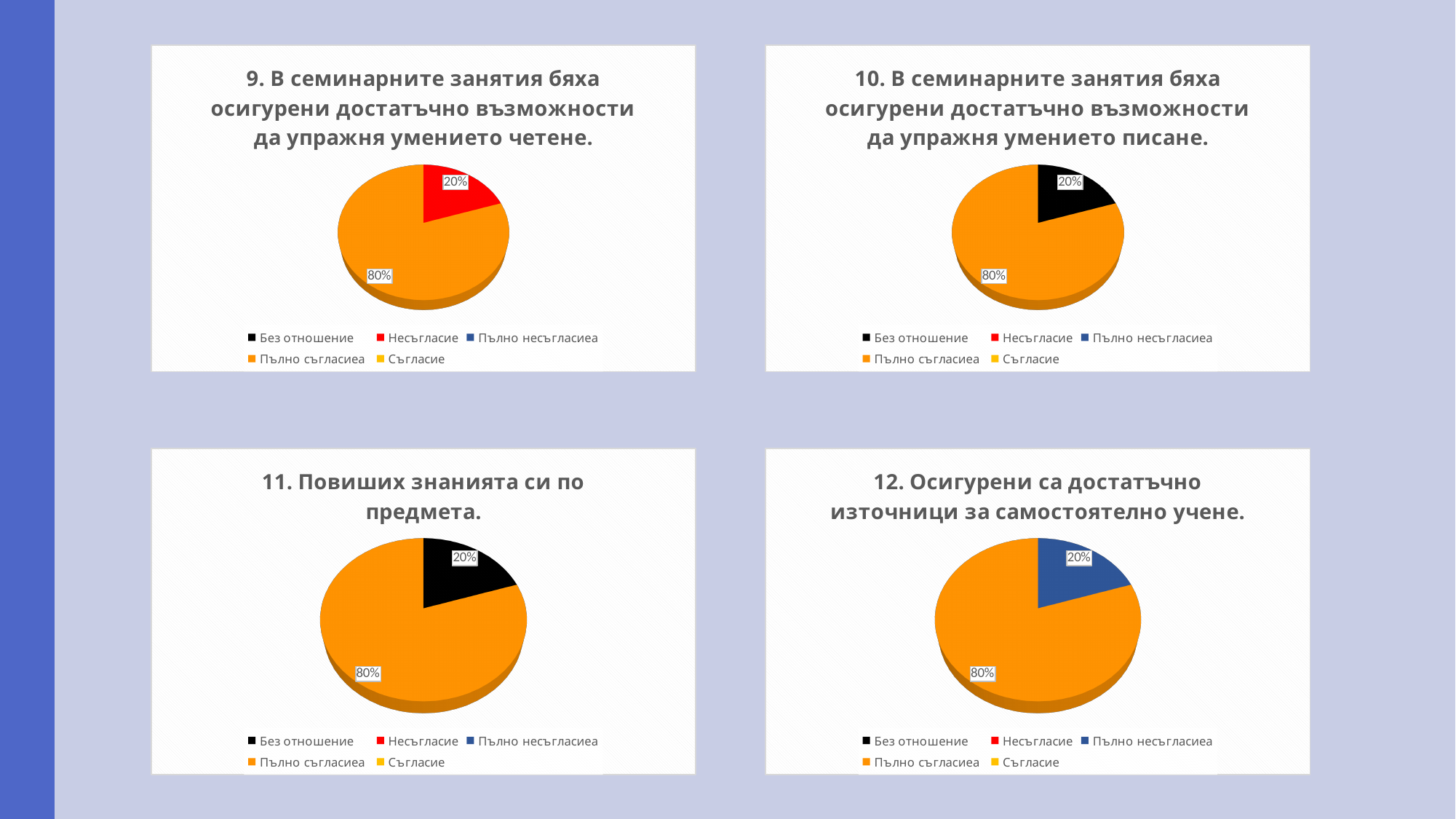
In the top-right chart (question 10), what share of the pie is the black 'Без отношение' slice? 20% In the bottom-left chart (question 11), which category has the largest slice? Пълно съгласиеа What colour is the 'Пълно съгласиеа' slice in the bottom-right chart (question 12)? Orange In the bottom-right chart (question 12), what share of the pie is the blue 'Пълно несъгласиеа' slice? 20% In the top-left chart (question 9), what share of the pie is the red 'Несъгласие' slice? 20% In the top-left chart (question 9), which is larger: the 'Несъгласие' slice or the 'Пълно съгласиеа' slice? Пълно съгласиеа How many slices are visible in the top-right chart (question 10)? 2 In the bottom-right chart (question 12), which category has the smallest visible slice? Пълно несъгласиеа How many entries does the legend of the bottom-left chart (question 11) list? 5 In the bottom-left chart (question 11), what is the difference between the 'Пълно съгласиеа' slice and the 'Без отношение' slice? 60% What kind of chart is the top-left chart (question 9)? Pie chart